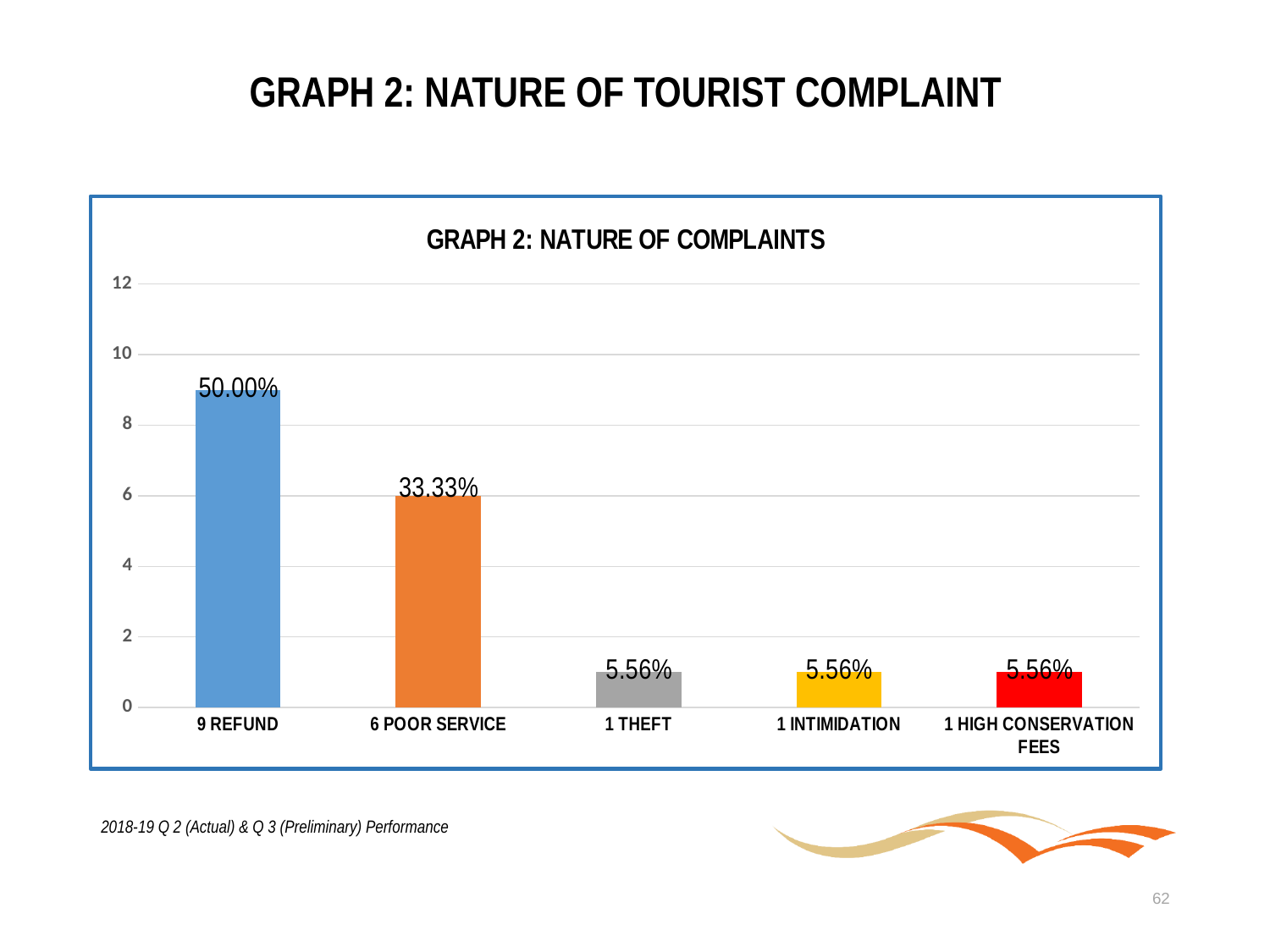
Which is larger, the bar for 6 POOR SERVICE or the bar for 1 INTIMIDATION? 6 POOR SERVICE Is the value for 1 THEFT greater or less than 2 on the vertical axis? less What data label is shown on the 9 REFUND bar? 50.00% What data label is shown on the 1 THEFT bar? 5.56% What is the difference between the data labels for 9 REFUND and 6 POOR SERVICE? 16.67% How many categories are shown on the chart? 5 Which category has the highest bar? 9 REFUND What kind of chart is shown? Bar chart What data label is shown on the 1 HIGH CONSERVATION FEES bar? 5.56% Is the value for 9 REFUND greater or less than 8 on the vertical axis? greater What is the title printed inside the chart area? GRAPH 2: NATURE OF COMPLAINTS What data label is shown on the 6 POOR SERVICE bar? 33.33%